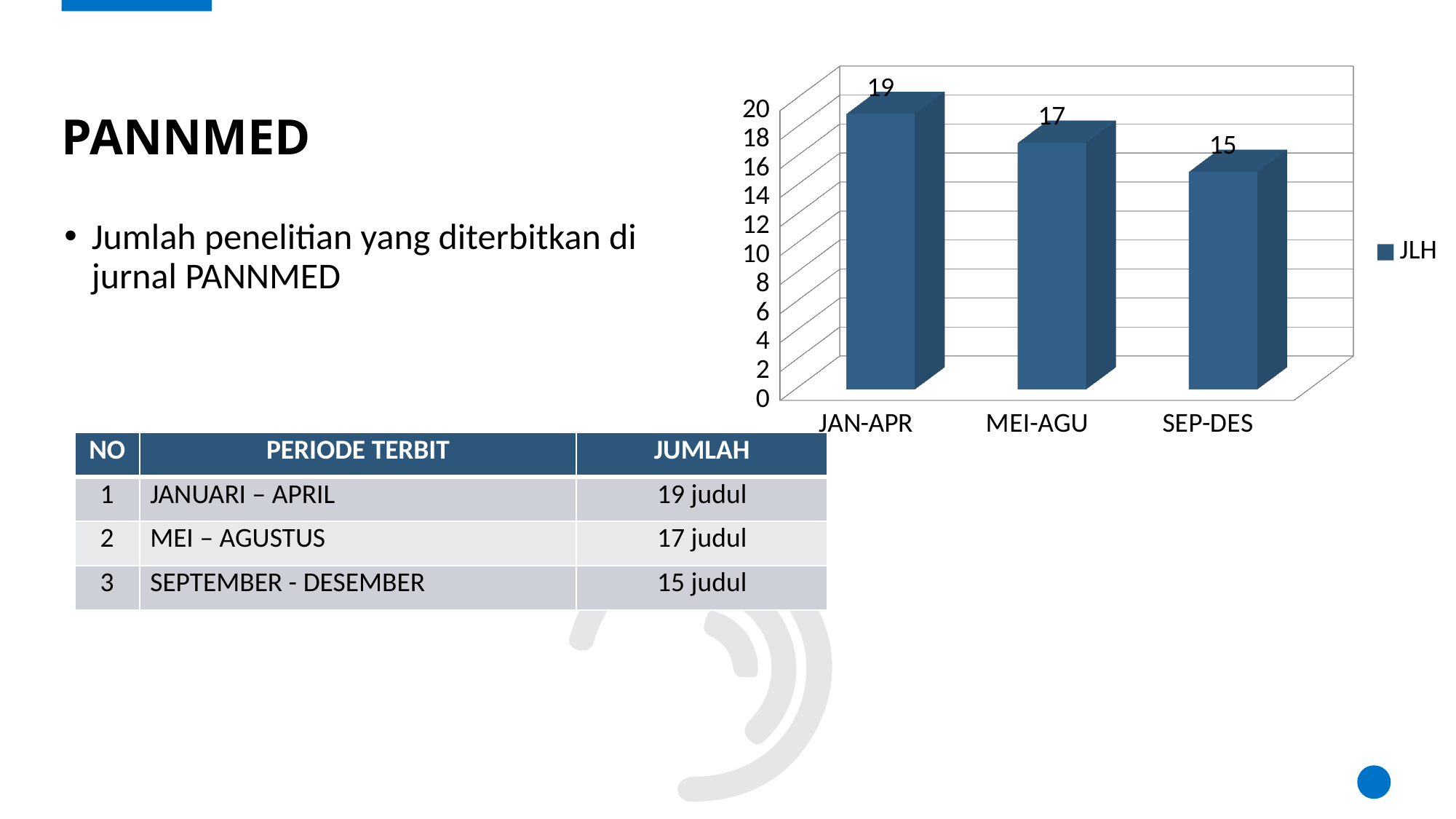
How many series does the chart legend list? 1 What kind of chart is shown on the slide? bar chart Which is larger, the value for JAN-APR or the value for MEI-AGU? JAN-APR What is the value for MEI-AGU in the chart? 17 What is the difference between the values for JAN-APR and SEP-DES? 4 What is the value for SEP-DES in the chart? 15 How many categories are shown on the x axis of the chart? 3 What is the value for JAN-APR in the chart? 19 What is the difference between the values for MEI-AGU and SEP-DES? 2 Which category has the highest value in the chart? JAN-APR Which category has the lowest value in the chart? SEP-DES Do the values rise or fall from JAN-APR to SEP-DES? fall